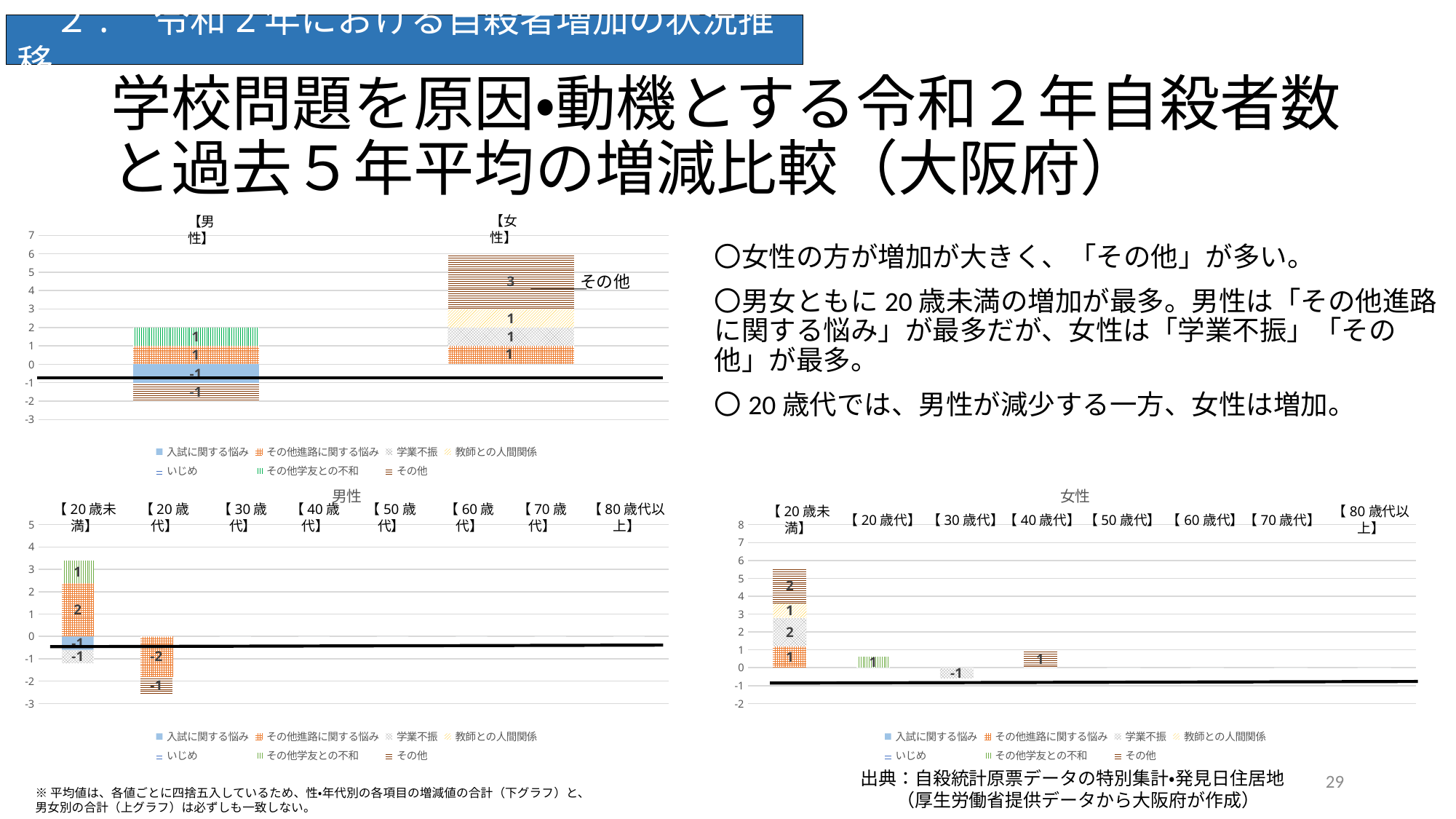
How many series does the legend of the top-left chart list? 7 How many age-group categories are shown on the x axis of the bottom-right 女性 chart? 8 In the bottom-right 女性 chart, what is the value of the その他 segment for 40歳代? 1 In the top-left chart, what is the value of the 入試に関する悩み segment for 男性? -1 In the bottom-right 女性 chart, what is the value of the 学業不振 segment for 30歳代? -1 In the top-left chart, what is the value of the その他 segment for 女性? 3 In the bottom-left 男性 chart, what is the value of the その他進路に関する悩み segment for 20歳未満? 2 In the top-left chart, what is the value of the 教師との人間関係 segment for 女性? 1 In the bottom-right 女性 chart, what is the value of the 学業不振 segment for 20歳未満? 2 In the bottom-left 男性 chart, what is the value of the その他 segment for 20歳代? -1 In the bottom-left 男性 chart, what is the value of the その他進路に関する悩み segment for 20歳代? -2 What kind of chart is the bottom-left 男性 chart? stacked bar chart